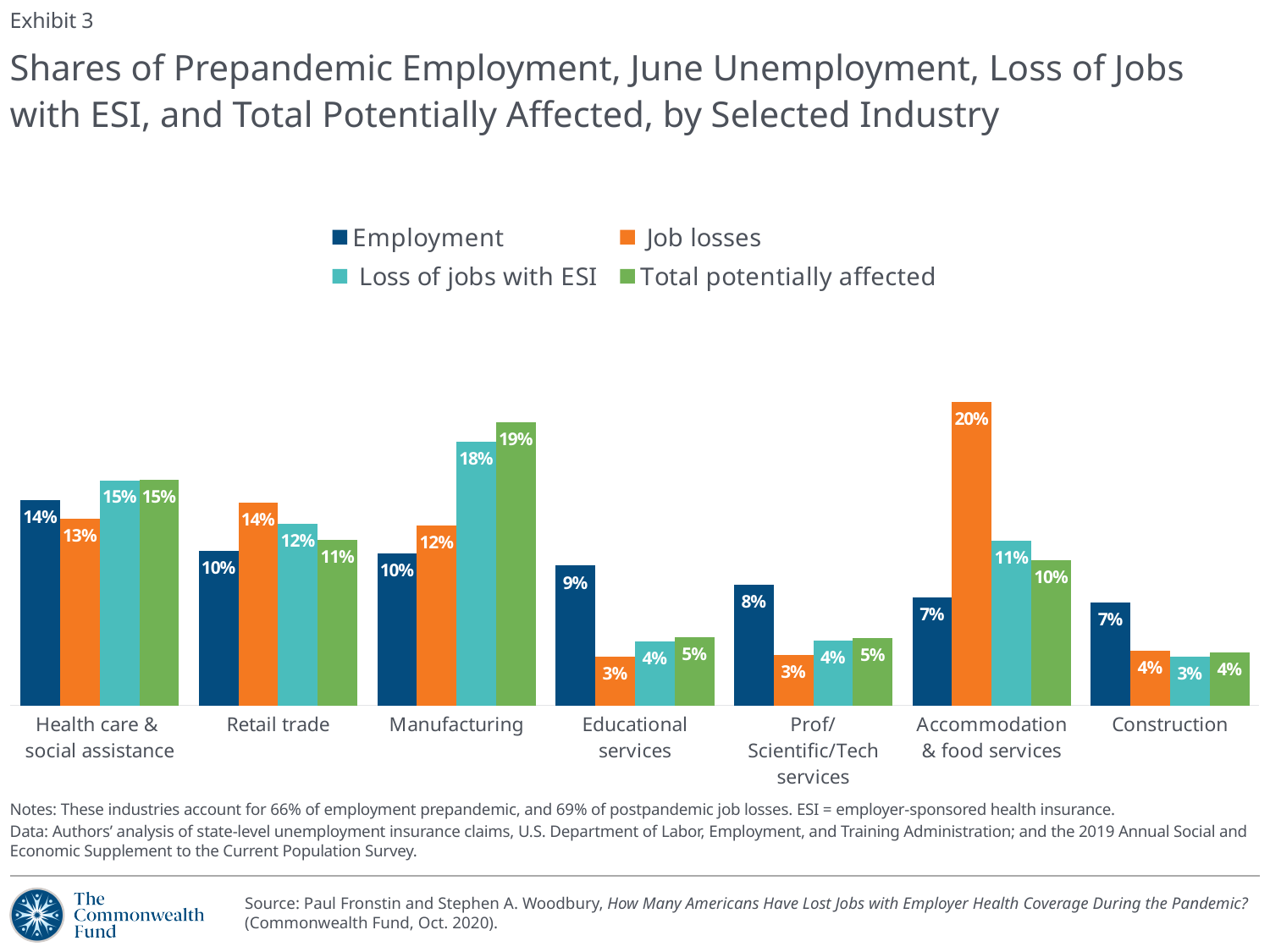
Which is larger for Retail trade: the Employment value or the Job losses value? Job losses Which industry has the highest Job losses value? Accommodation & food services What kind of chart is shown on the slide? Bar chart What is the Job losses value for Accommodation & food services? 20% What is the Employment value for Educational services? 9% What is the Total potentially affected value for Manufacturing? 19% How many industries are shown on the x axis? 7 What is the Loss of jobs with ESI value for Construction? 3% What is the difference between the Loss of jobs with ESI value for Manufacturing and for Retail trade? 6% Which industry has the lowest Employment value? Accommodation & food services and Construction (both 7%) Which series is shown in orange in the legend? Job losses How many series does the legend list? 4